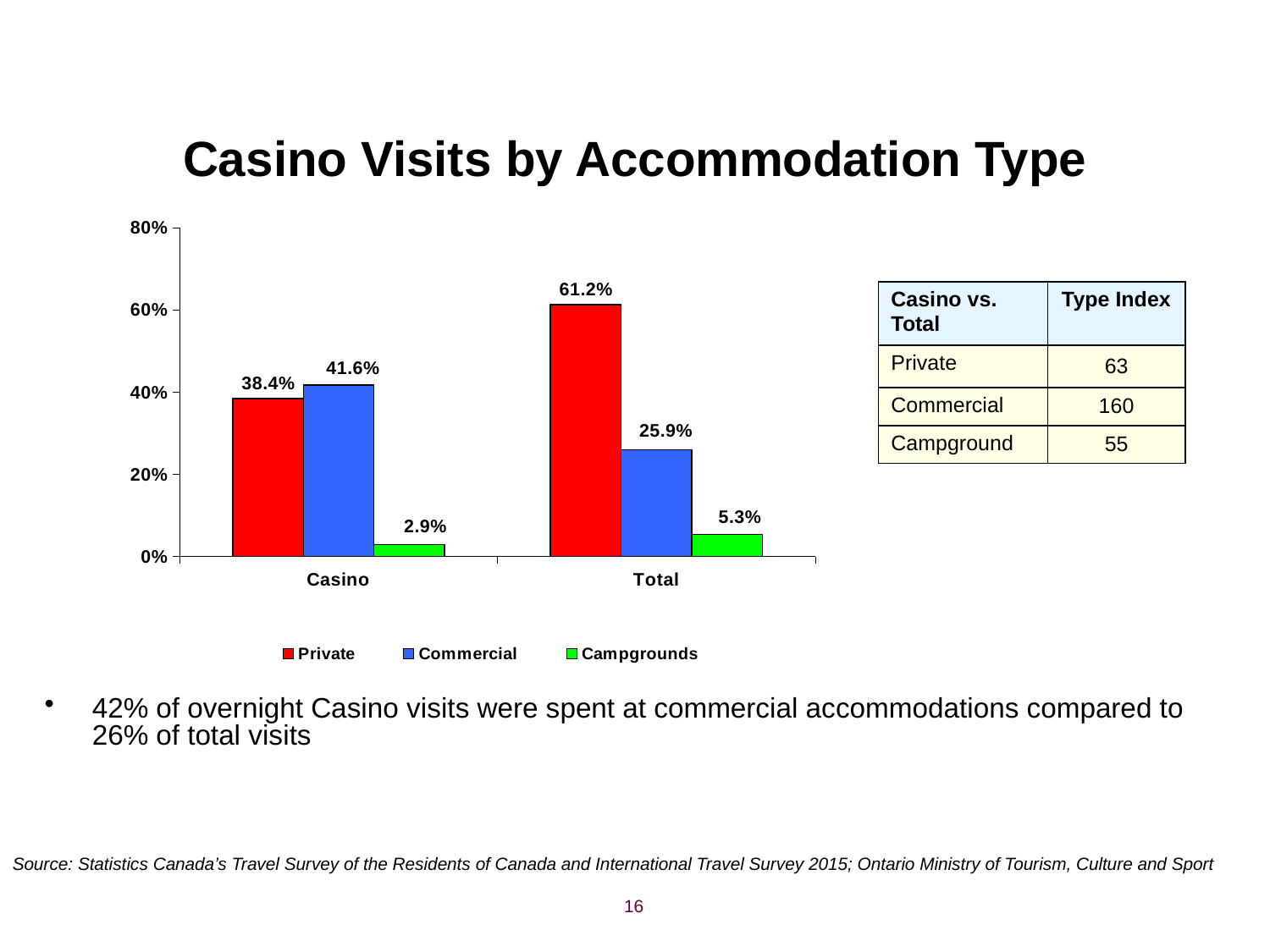
Which is larger: Private for Casino or Private for Total? Private for Total What is the title of the chart? Casino Visits by Accommodation Type What is the value for Private in the Total category? 61.2% How many series does the legend list? 3 Which series has the lowest value in the Casino category? Campgrounds What is the value for Campgrounds in the Casino category? 2.9% What kind of chart is shown on the slide? Bar chart What is the difference between the Commercial values for Casino and Total? 15.7% How many categories are shown on the x axis? 2 What is the value for Campgrounds in the Total category? 5.3% Which series has the highest value in the Total category? Private What is the value for Commercial in the Casino category? 41.6%